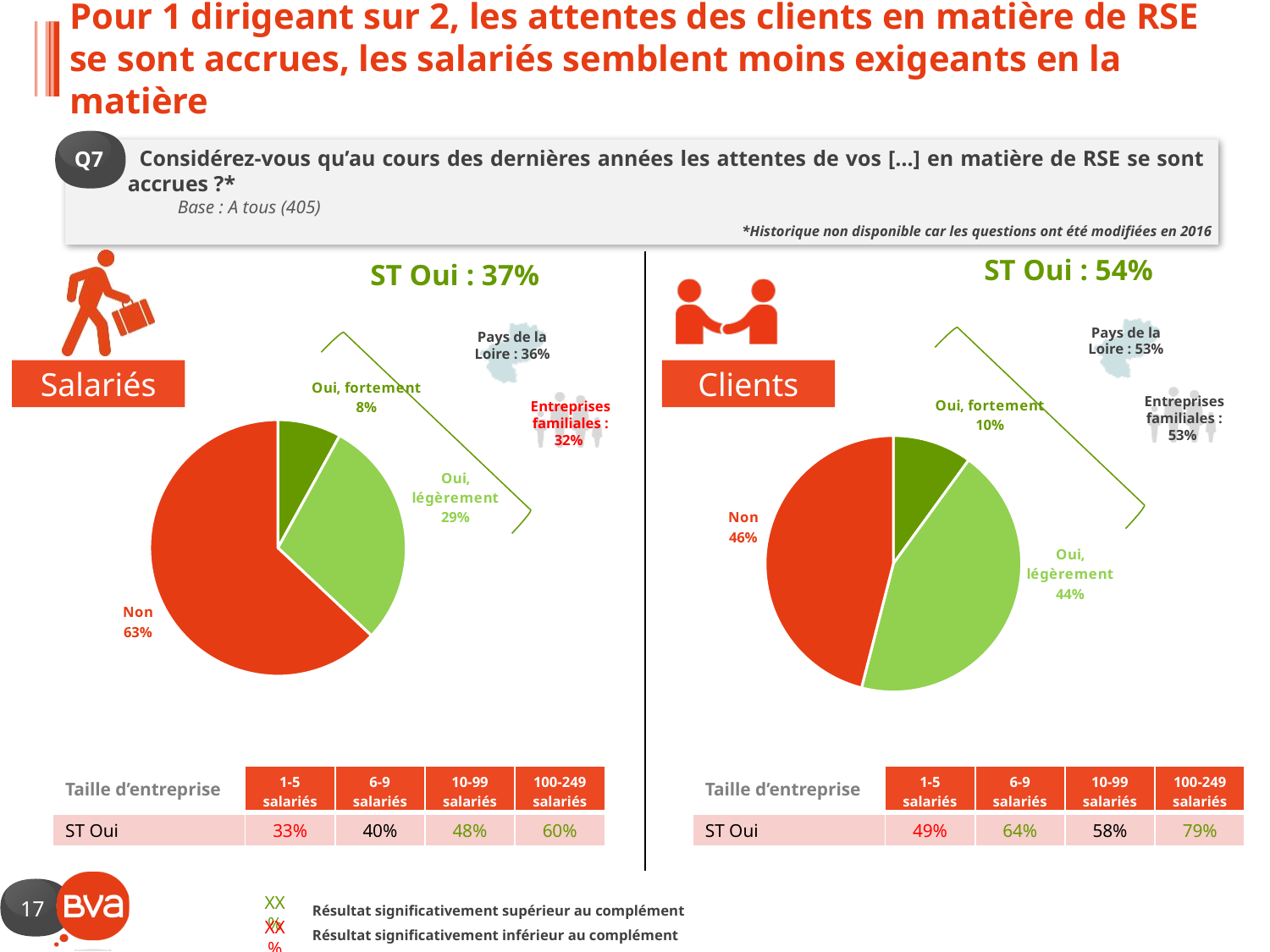
In the Salariés pie chart on the left, what is the share for "Non"? 63% In the Clients pie chart on the right, what is the share for "Oui, légèrement"? 44% In the Salariés pie chart on the left, which category has the largest slice? Non Which is larger: "Oui, légèrement" in the Salariés pie chart or "Oui, légèrement" in the Clients pie chart? Clients (44%) In the Clients pie chart on the right, which category has the smallest slice? Oui, fortement How many slices does the Salariés pie chart on the left have? 3 In the Clients pie chart on the right, what is the share for "Oui, fortement"? 10% In the Salariés pie chart on the left, what is the share for "Oui, fortement"? 8% In the Clients pie chart on the right, what is the share for "Non"? 46% What kind of chart is used for the Salariés data on the left? Pie chart In the Salariés pie chart on the left, what is the share for "Oui, légèrement"? 29% What is the difference between the "Non" share in the Salariés pie chart and the "Non" share in the Clients pie chart? 17 percentage points